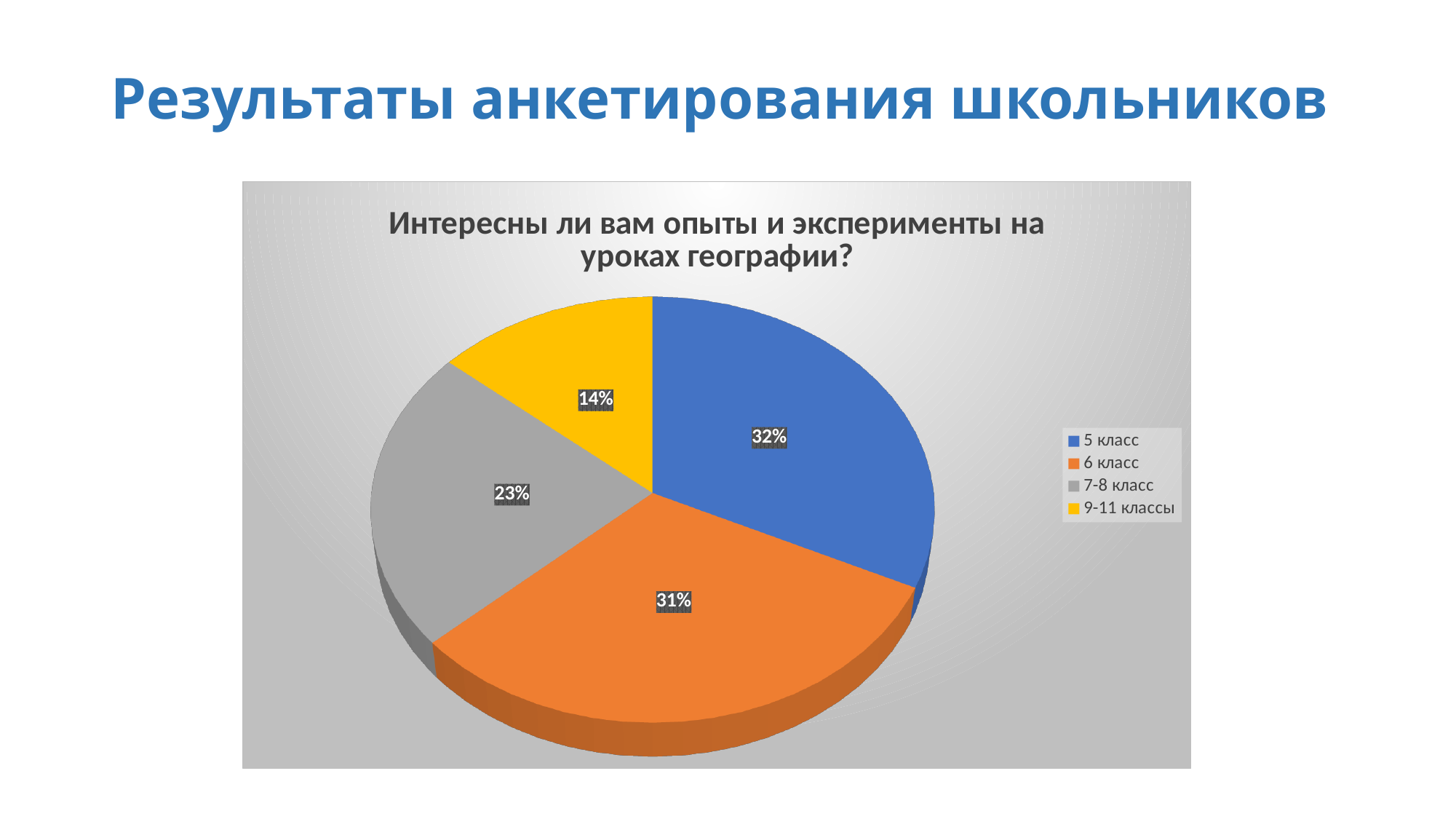
Which slice is larger, 7-8 класс or 9-11 классы? 7-8 класс What is the title of the chart? Интересны ли вам опыты и эксперименты на уроках географии? How many slices does the pie chart have? 4 What percentage of the pie chart is labelled for 5 класс? 32% What is the difference between the 5 класс and 9-11 классы slices? 18% What percentage is shown for 7-8 класс? 23% Which category has the smallest slice of the pie? 9-11 классы What value is shown for the 6 класс slice? 31% What percentage is shown for 9-11 классы? 14% How many entries does the legend list? 4 What type of chart is shown on the slide? Pie chart Which category has the largest slice of the pie? 5 класс